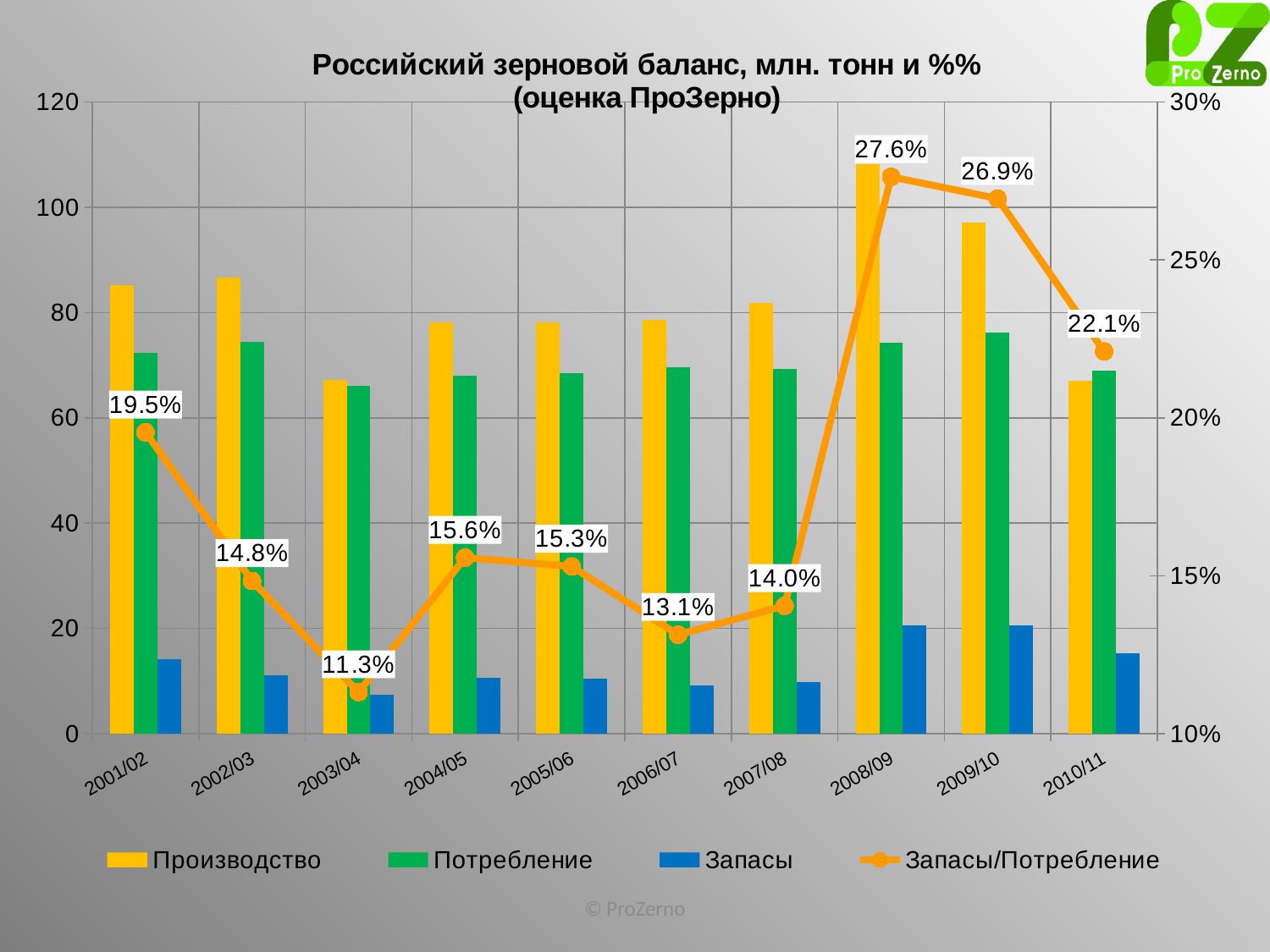
How many seasons are shown on the x axis? 10 What is the value of Запасы/Потребление for 2003/04? 11.3% What is the value of Запасы/Потребление for 2008/09? 27.6% In which season is the Производство bar the tallest? 2008/09 How many series does the legend list? 4 In which season is Запасы/Потребление the lowest? 2003/04 Is the value of Запасы for 2003/04 greater or less than 20? less What is the value of Запасы/Потребление for 2010/11? 22.1% Is the value of Производство for 2008/09 greater or less than 100? greater In which season is Запасы/Потребление the highest? 2008/09 What is the difference between Запасы/Потребление in 2008/09 and in 2001/02? 8.1 percentage points Which is larger, Запасы/Потребление in 2009/10 or in 2010/11? 2009/10